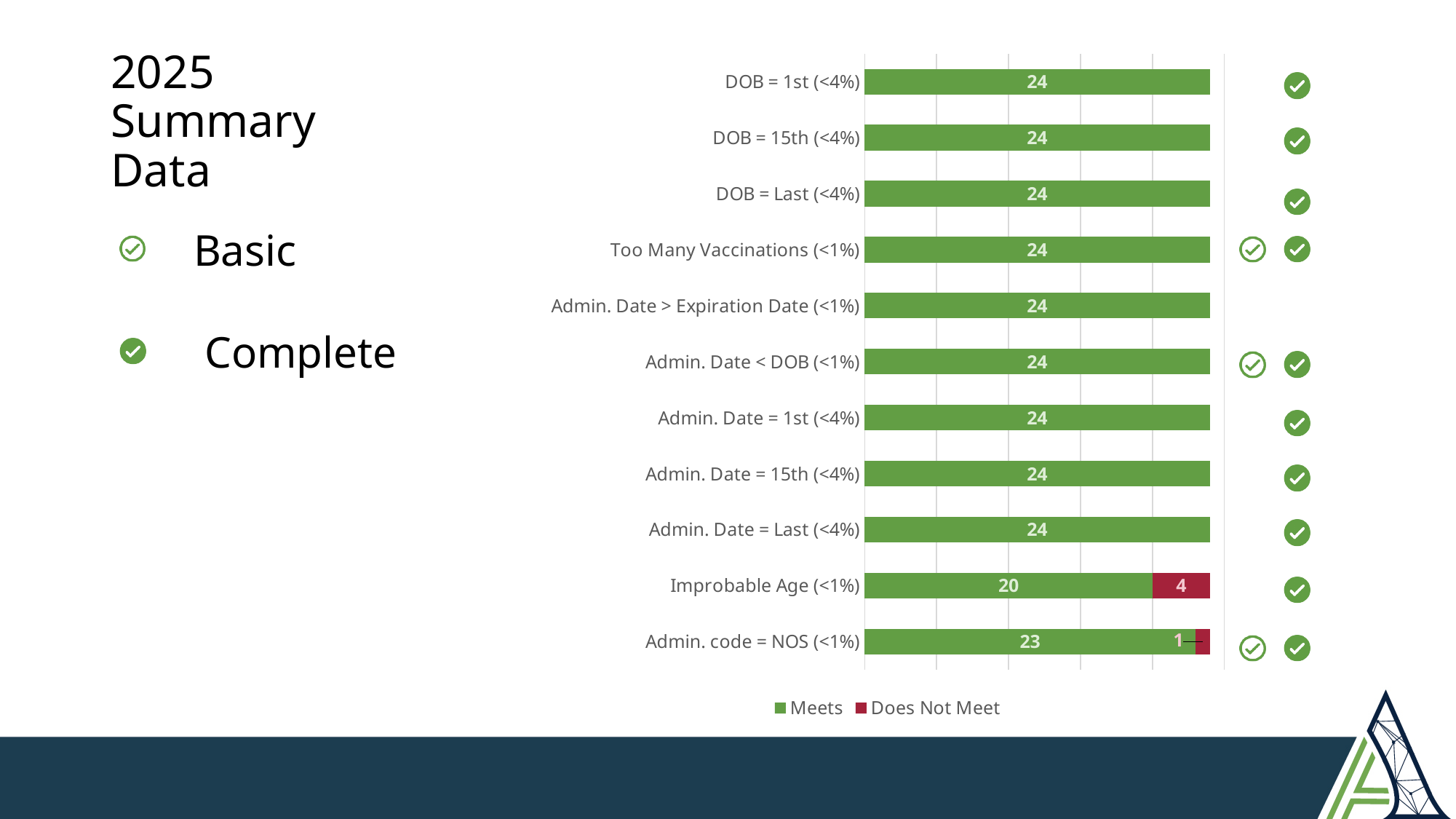
What is the difference between the Meets values for Admin. code = NOS (<1%) and Improbable Age (<1%)? 3 What is the Meets value for Improbable Age (<1%)? 20 Which category has the highest Does Not Meet value? Improbable Age (<1%) How many series does the legend list? 2 What kind of chart is shown on the slide? Stacked bar chart Which category has the lowest Meets value? Improbable Age (<1%) What colour represents the Does Not Meet series in the legend? Red Which is larger, the Does Not Meet value for Improbable Age (<1%) or for Admin. code = NOS (<1%)? Improbable Age (<1%) How many categories are shown in the chart? 11 What is the Does Not Meet value for Admin. code = NOS (<1%)? 1 What is the total of the stacked bar for Improbable Age (<1%)? 24 What is the Meets value for DOB = 1st (<4%)? 24